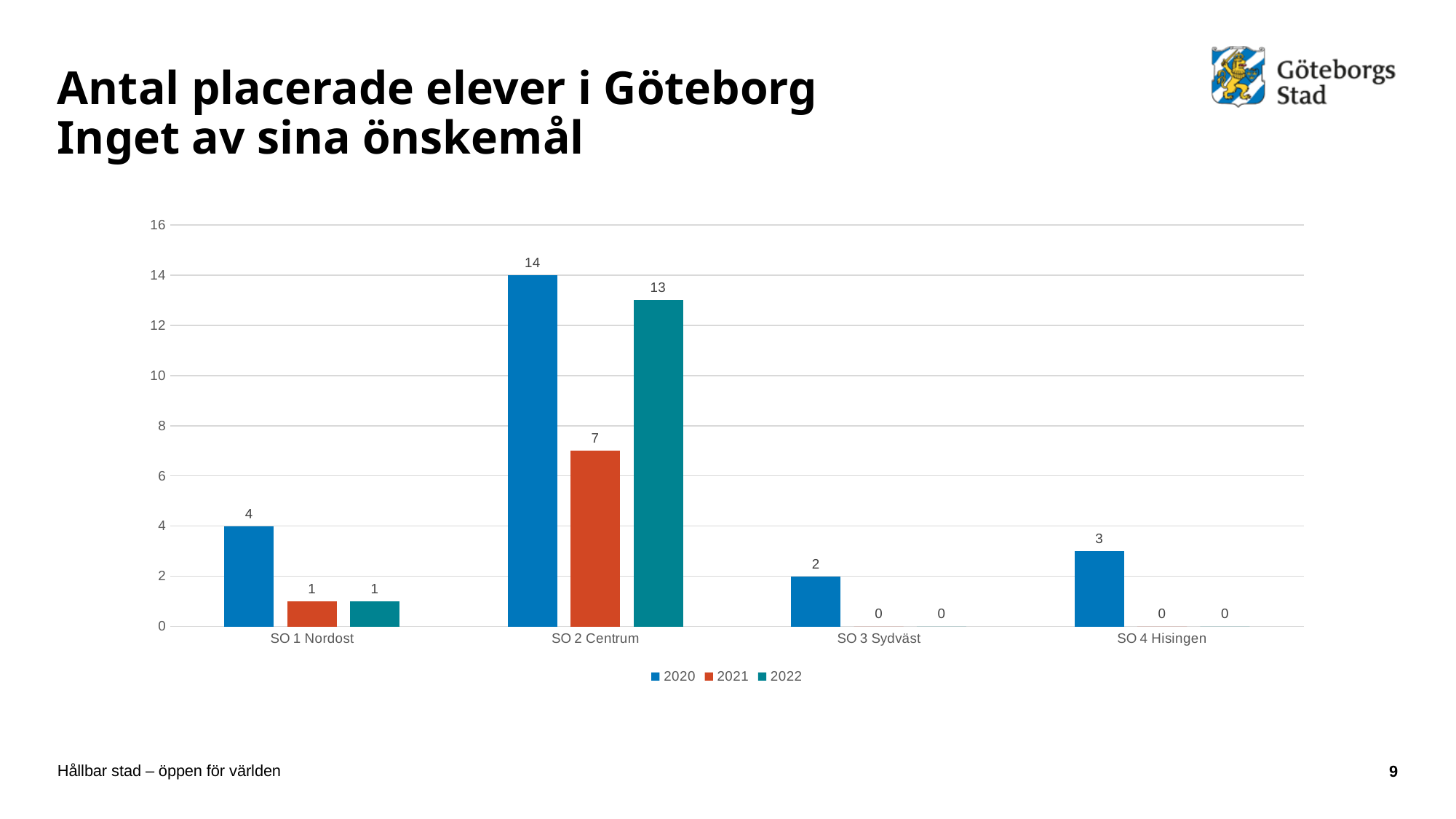
What is the value for 2021 in SO 1 Nordost? 1 Which category has the lowest value for 2020? SO 3 Sydväst What is the difference between the 2020 and 2021 values in SO 2 Centrum? 7 Which category has the highest value for 2020? SO 2 Centrum What kind of chart is shown on the slide? Bar chart What is the value for 2020 in SO 4 Hisingen? 3 How many series does the legend list? 3 How many categories are shown on the x axis? 4 Which is larger in SO 1 Nordost, the 2020 value or the 2022 value? 2020 What is the value for 2022 in SO 3 Sydväst? 0 What is the value for 2022 in SO 2 Centrum? 13 What is the value for 2020 in SO 2 Centrum? 14